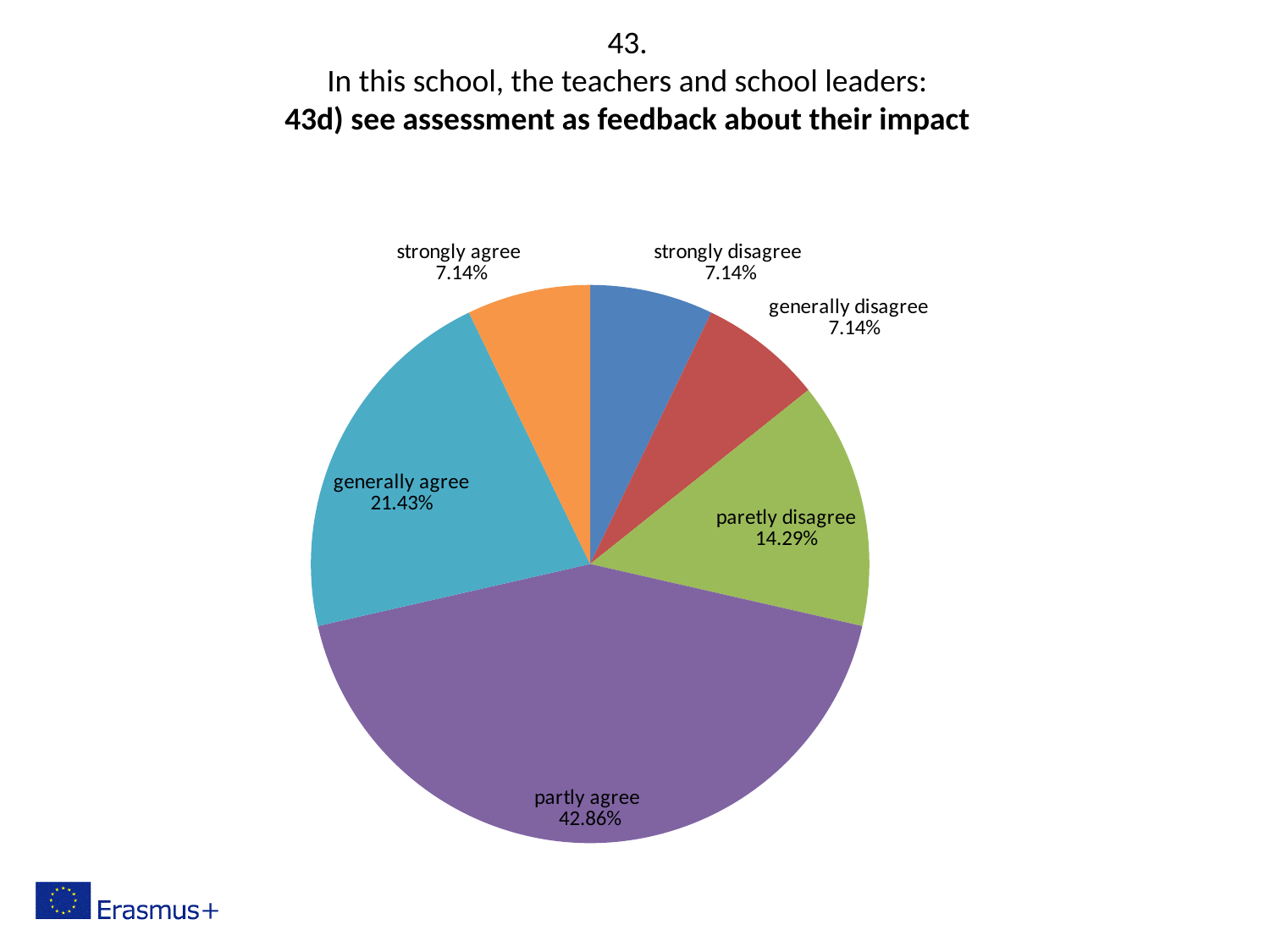
What kind of chart is shown on the slide? pie chart What is the value shown for "paretly disagree"? 14.29% What is the difference between the "partly agree" and "generally agree" shares? 21.43% Which category has the largest slice of the pie? partly agree What share of the pie does "partly agree" have? 42.86% How many slices does the pie chart have? 6 What is the difference between the "generally agree" and "paretly disagree" shares? 7.14% What is the value shown for "generally agree"? 21.43% What colour is the "partly agree" slice? purple Which is larger, the slice for "generally agree" or the slice for "paretly disagree"? generally agree How many categories share the value 7.14%? 3 What is the value shown for "strongly agree"? 7.14%